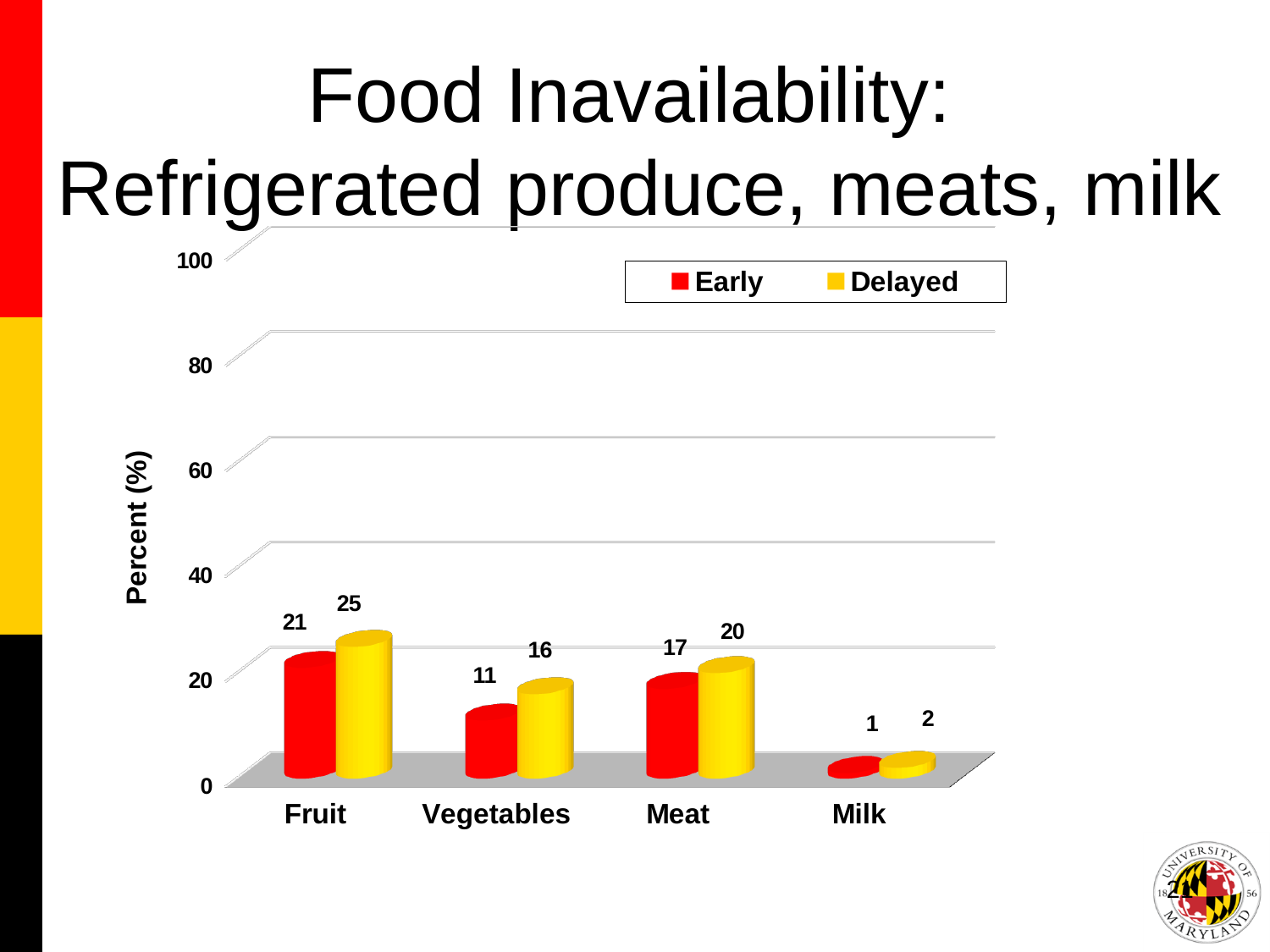
What kind of chart is shown on the slide? bar chart Is the Delayed value for Fruit greater or less than 20? greater How many series does the legend list? 2 Which category has the lowest Early value? Milk Which is larger for Meat, the Early value or the Delayed value? Delayed What is the difference between the Delayed and Early values for Vegetables? 5 What is the Delayed value for Meat? 20 How many food categories are shown on the x axis? 4 What is the label of the y axis? Percent (%) What is the Early value for Vegetables? 11 Which category has the highest Delayed value? Fruit What is the Early value for Fruit? 21